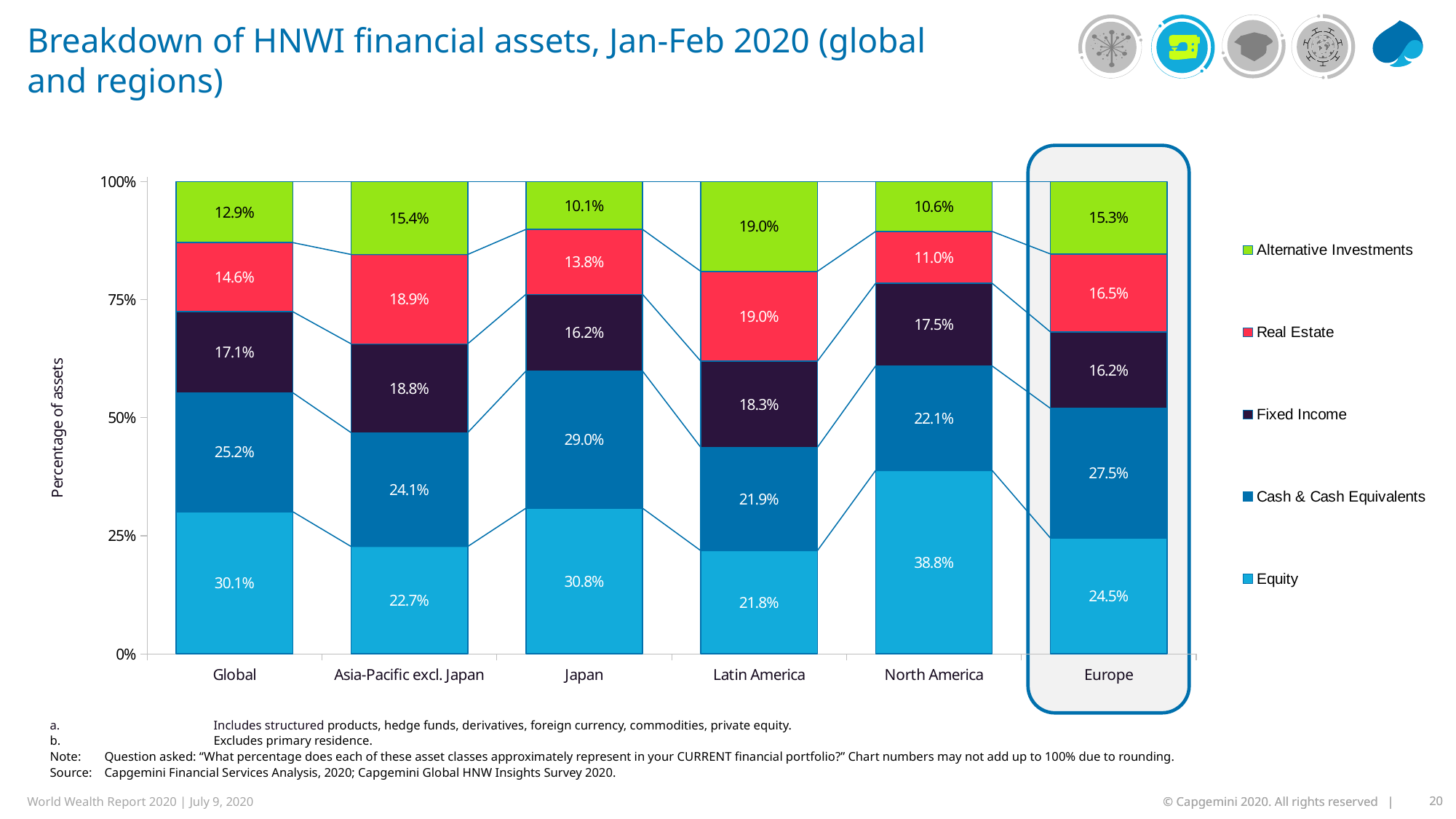
What is the difference between the Equity share for Global and for Asia-Pacific excl. Japan? 7.4% Which category on the chart is highlighted with a rounded box? Europe What is the Alternative Investments share for Latin America? 19.0% What is the Cash & Cash Equivalents value for Europe? 27.5% Which region has the lowest Alternative Investments share? Japan Which is larger, the Fixed Income share for Global or for North America? North America What is the Equity share for North America? 38.8% How many series does the legend list? 5 How many regions/categories are shown on the x axis? 6 What percentage of assets is Real Estate for Asia-Pacific excl. Japan? 18.9% Which region has the highest Equity share? North America What kind of chart is shown on the slide? Stacked bar chart